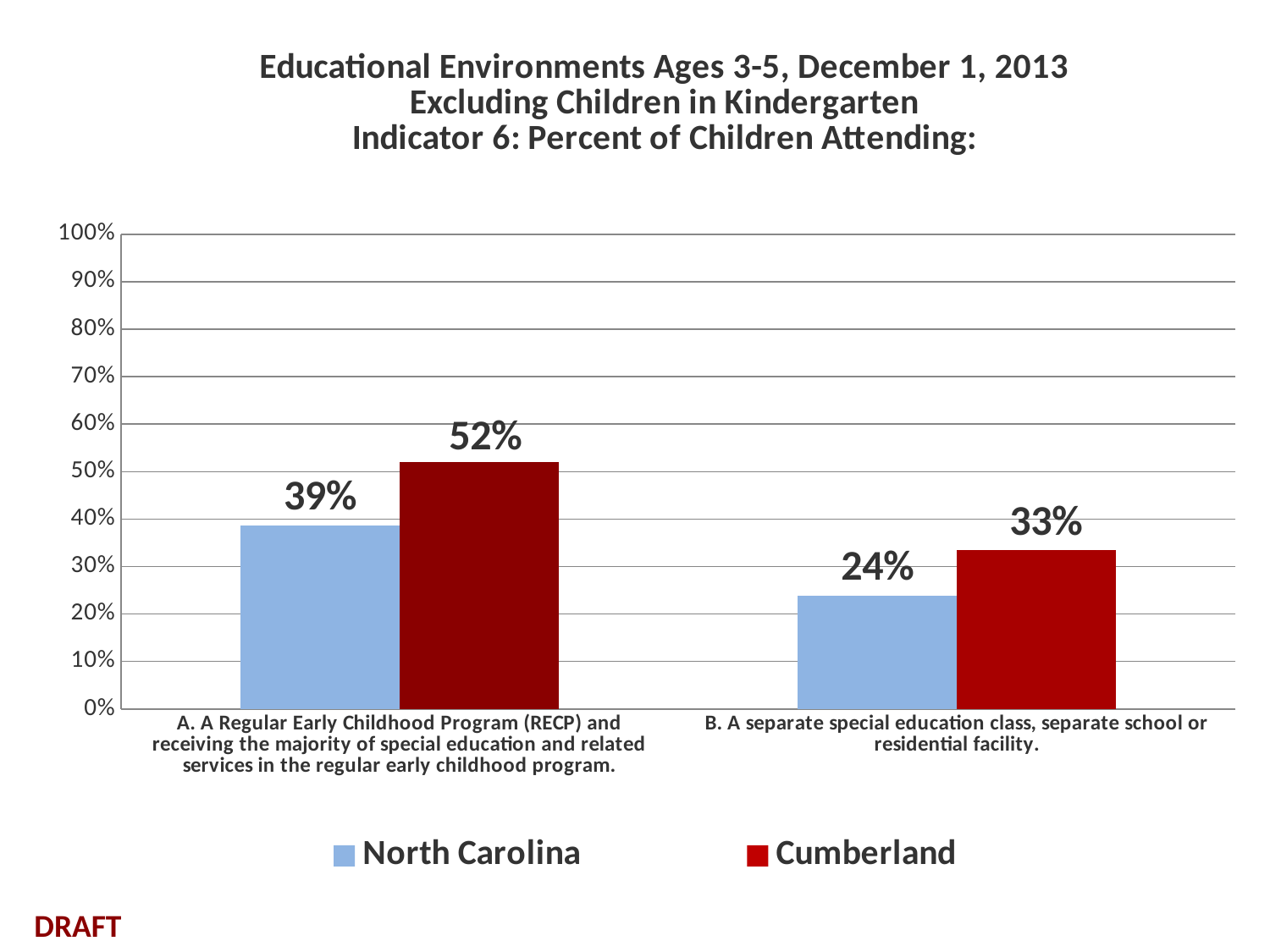
How many categories are shown on the x axis? 2 Which bar on the chart has the lowest value? North Carolina in category B (24%) What is the difference between Cumberland and North Carolina in category A? 13% Which series has the highest value in category A? Cumberland Which is larger: North Carolina in category A or Cumberland in category B? North Carolina in category A What is the value for Cumberland in category B (separate special education class, separate school or residential facility)? 33% What is the value for North Carolina in category B (separate special education class, separate school or residential facility)? 24% What kind of chart is shown on the slide? Bar chart What is the difference between Cumberland and North Carolina in category B? 9% What is the value for North Carolina in category A (Regular Early Childhood Program)? 39% What is the value for Cumberland in category A (Regular Early Childhood Program)? 52% How many series does the legend list? 2